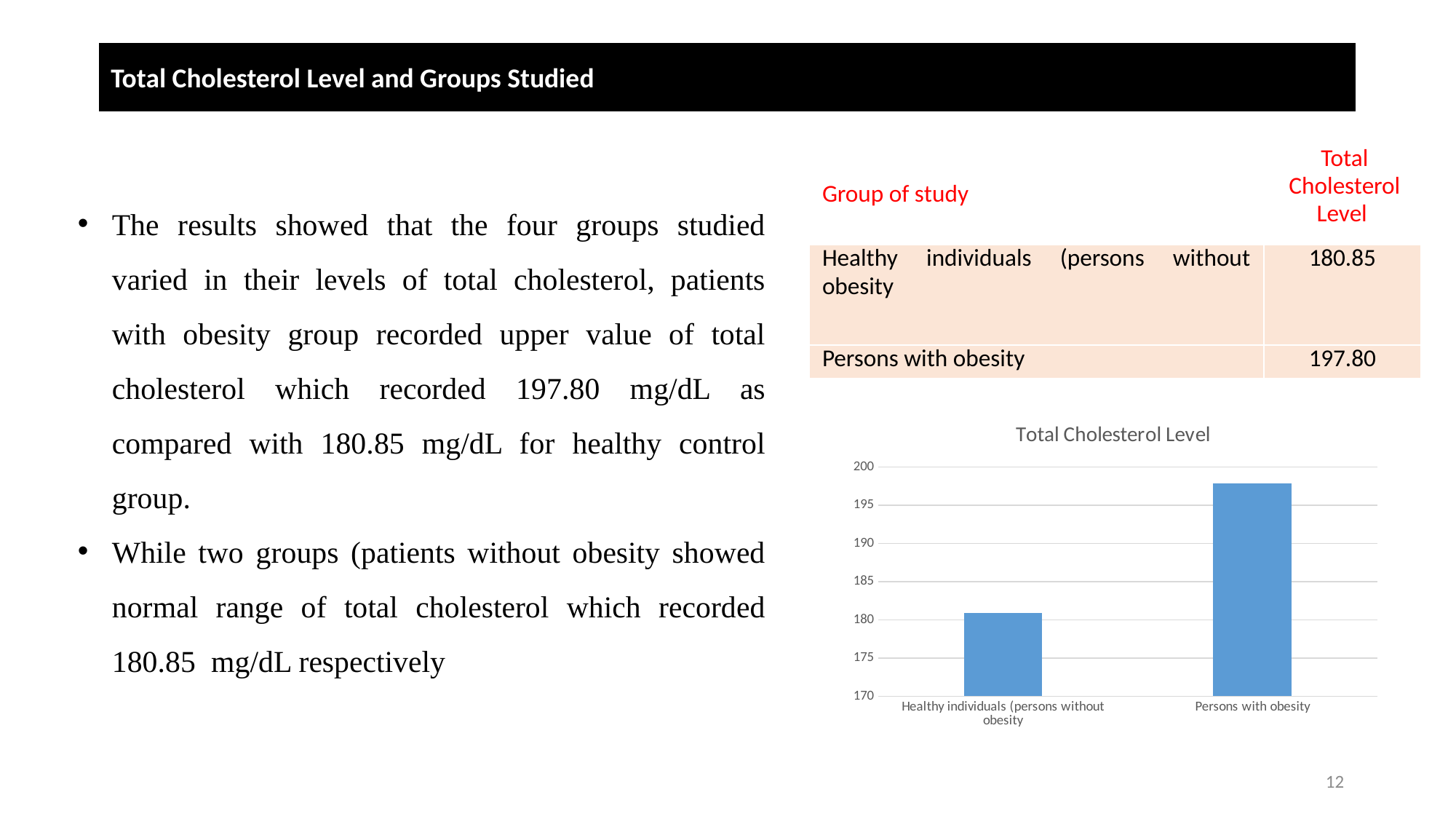
What is the total cholesterol level for Healthy individuals (persons without obesity, as printed on the slide? 180.85 What is the difference between the total cholesterol level for Persons with obesity and for Healthy individuals (persons without obesity? 16.95 Is the value for Persons with obesity greater or less than 195? greater How many categories are plotted in the chart? 2 Is the value for Healthy individuals (persons without obesity greater or less than 185? less Which group has the highest total cholesterol level in the chart? Persons with obesity What type of chart is shown on the slide? bar chart Which group has the lowest total cholesterol level in the chart? Healthy individuals (persons without obesity Which is larger, the total cholesterol level for Persons with obesity or for Healthy individuals (persons without obesity? Persons with obesity What is the total cholesterol level for Persons with obesity, as printed on the slide? 197.80 What is the title of the chart? Total Cholesterol Level Do the values rise or fall from left to right across the chart? rise